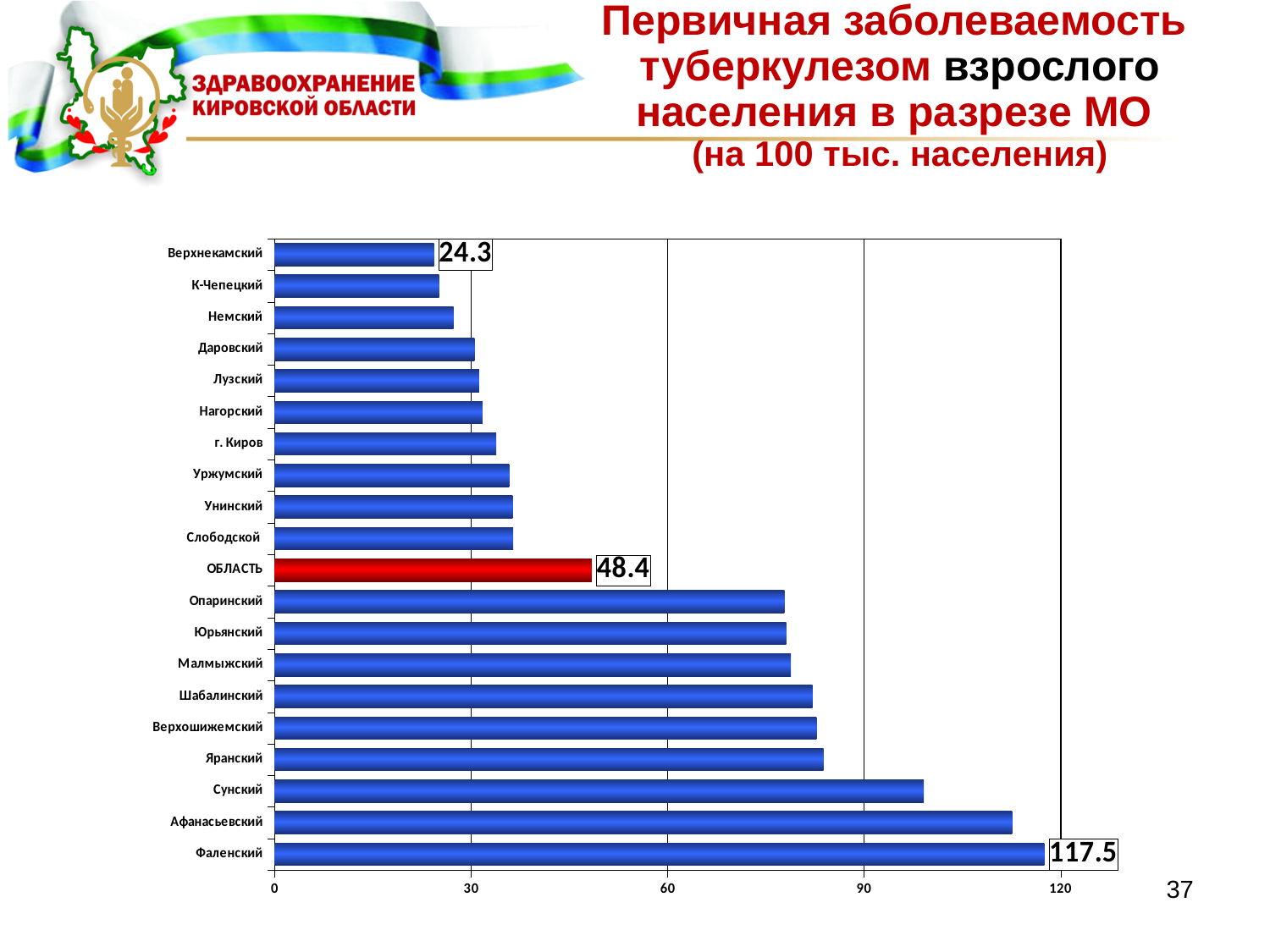
Is the value for Афанасьевский greater or less than 90? greater What is the difference between the values for Фаленский and ОБЛАСТЬ? 69.1 What is the value for Фаленский? 117.5 What is the value for ОБЛАСТЬ? 48.4 Is the value for Немский greater or less than 30? less What is the difference between the values for ОБЛАСТЬ and Верхнекамский? 24.1 Which category has the highest value? Фаленский What kind of chart is shown on the slide? bar chart Which is larger, the value for Сунский or the value for Яранский? Сунский How many categories are shown on the chart? 20 What is the value for Верхнекамский? 24.3 Which category has the lowest value? Верхнекамский